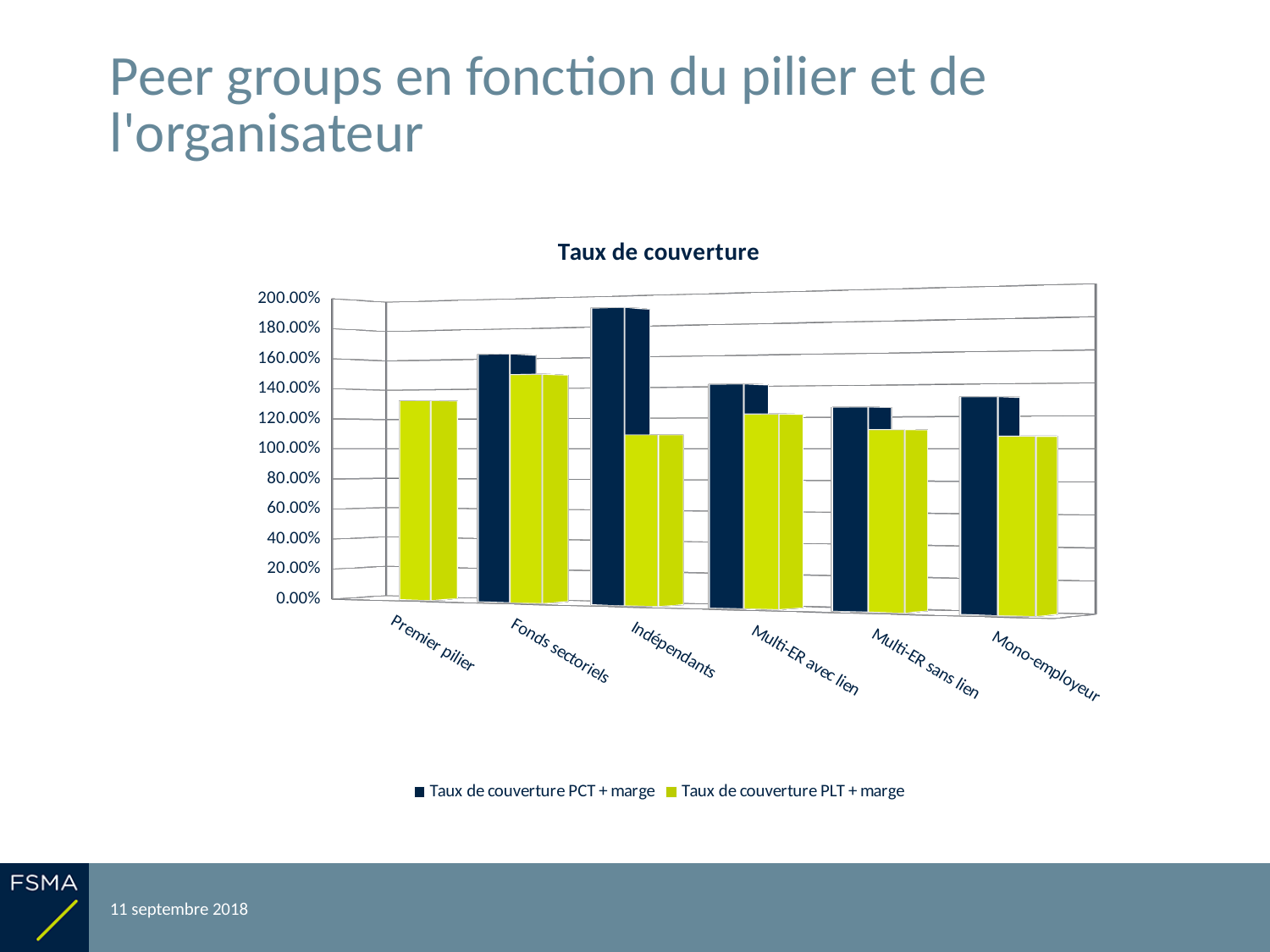
Is the Taux de couverture PLT + marge value for Fonds sectoriels greater or less than 140.00%? greater Which category has the highest value for Taux de couverture PCT + marge? Indépendants How many series does the legend list? 2 Which colour represents Taux de couverture PLT + marge in the legend? Yellow-green Is the Taux de couverture PLT + marge value for Indépendants greater or less than 120.00%? less How many categories are shown on the x axis? 6 Which is larger: the Taux de couverture PCT + marge value for Fonds sectoriels or for Multi-ER sans lien? Fonds sectoriels Is the Taux de couverture PCT + marge value for Indépendants greater or less than 180.00%? greater For Indépendants, which is larger: Taux de couverture PCT + marge or Taux de couverture PLT + marge? Taux de couverture PCT + marge Which category has the highest value for Taux de couverture PLT + marge? Fonds sectoriels What kind of chart is shown on the slide? Bar chart What is the title of the chart? Taux de couverture